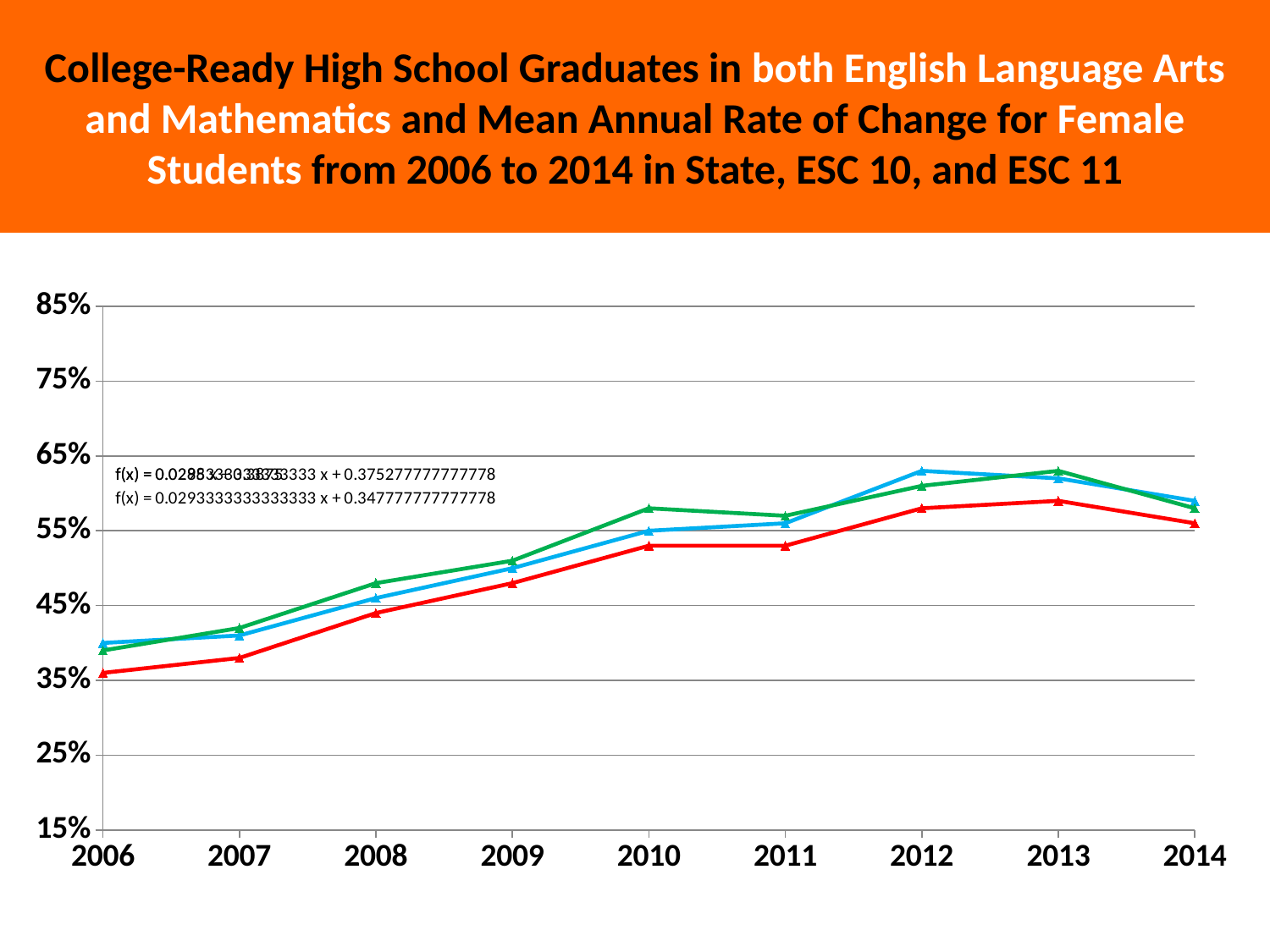
What is the highest value shown on the y axis? 85% In which year is the red line at its lowest value? 2006 What is the first year shown on the x axis? 2006 Is the value of the red line in 2006 greater or less than 45%? less Do the values of the red line generally rise or fall from 2006 to 2013? rise How many lines are plotted on the chart? 3 How many years are shown along the x axis of the chart? 9 Is the value of the blue line in 2014 greater or less than 55%? greater Is the value of the red line in 2011 greater or less than 55%? less In which year is the blue line at its lowest value? 2006 In 2010, which line has the higher value, the green line or the red line? green line What kind of chart is shown on the slide? line chart